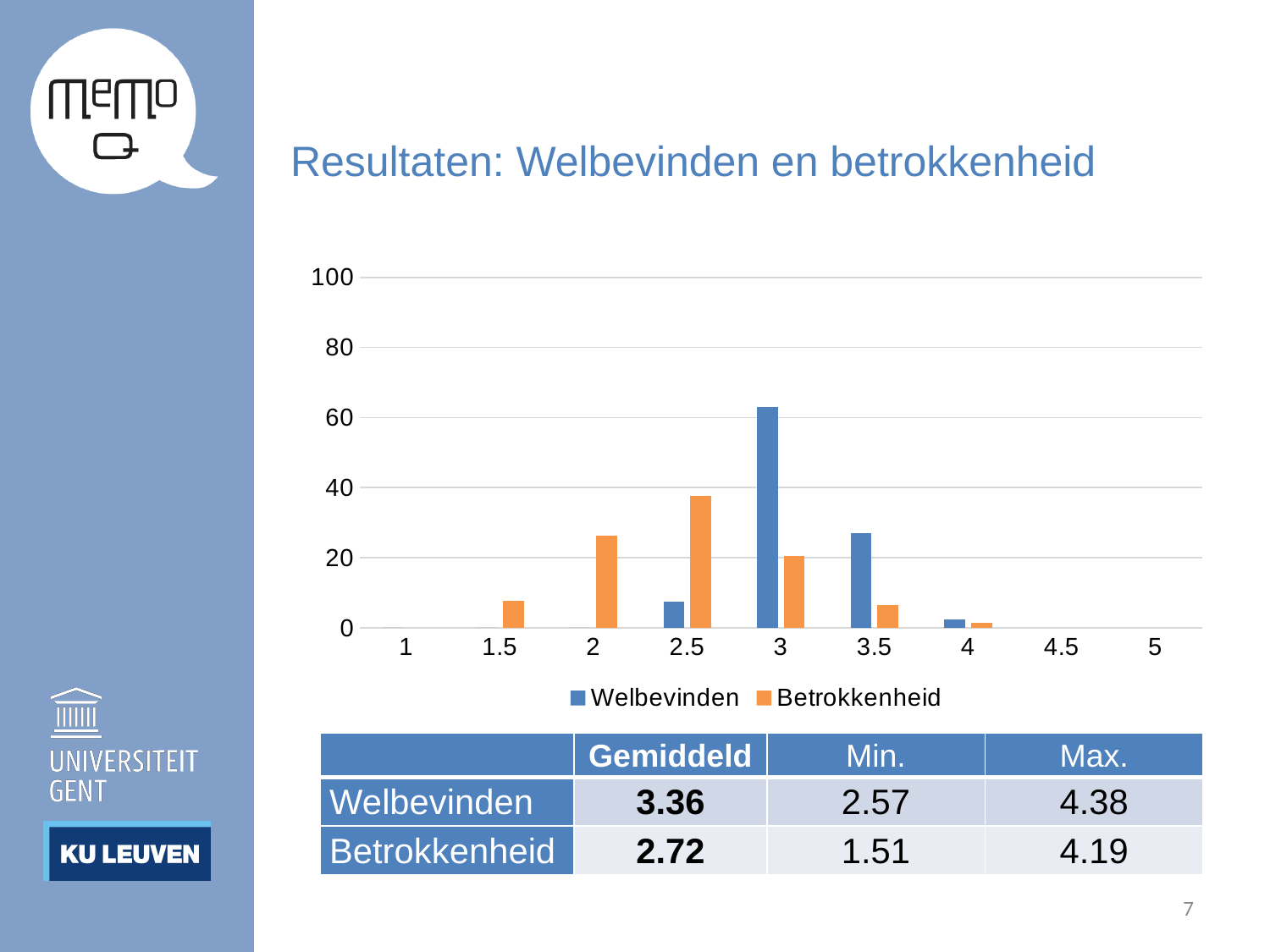
Is the Betrokkenheid value at category 2 greater or less than 20? greater At category 2.5, which series has the larger value, Welbevinden or Betrokkenheid? Betrokkenheid Is the Betrokkenheid value at category 2.5 greater or less than 20? greater At which x-axis category is the Betrokkenheid bar highest? 2.5 Is the Welbevinden value at category 3 greater or less than 40? greater How many categories are shown along the x axis of the chart? 9 What kind of chart is shown on the slide? bar chart At category 3, which series has the larger value, Welbevinden or Betrokkenheid? Welbevinden How many series does the chart legend list? 2 At which x-axis category is the Welbevinden bar highest? 3 Which colour represents the Betrokkenheid series in the chart? orange